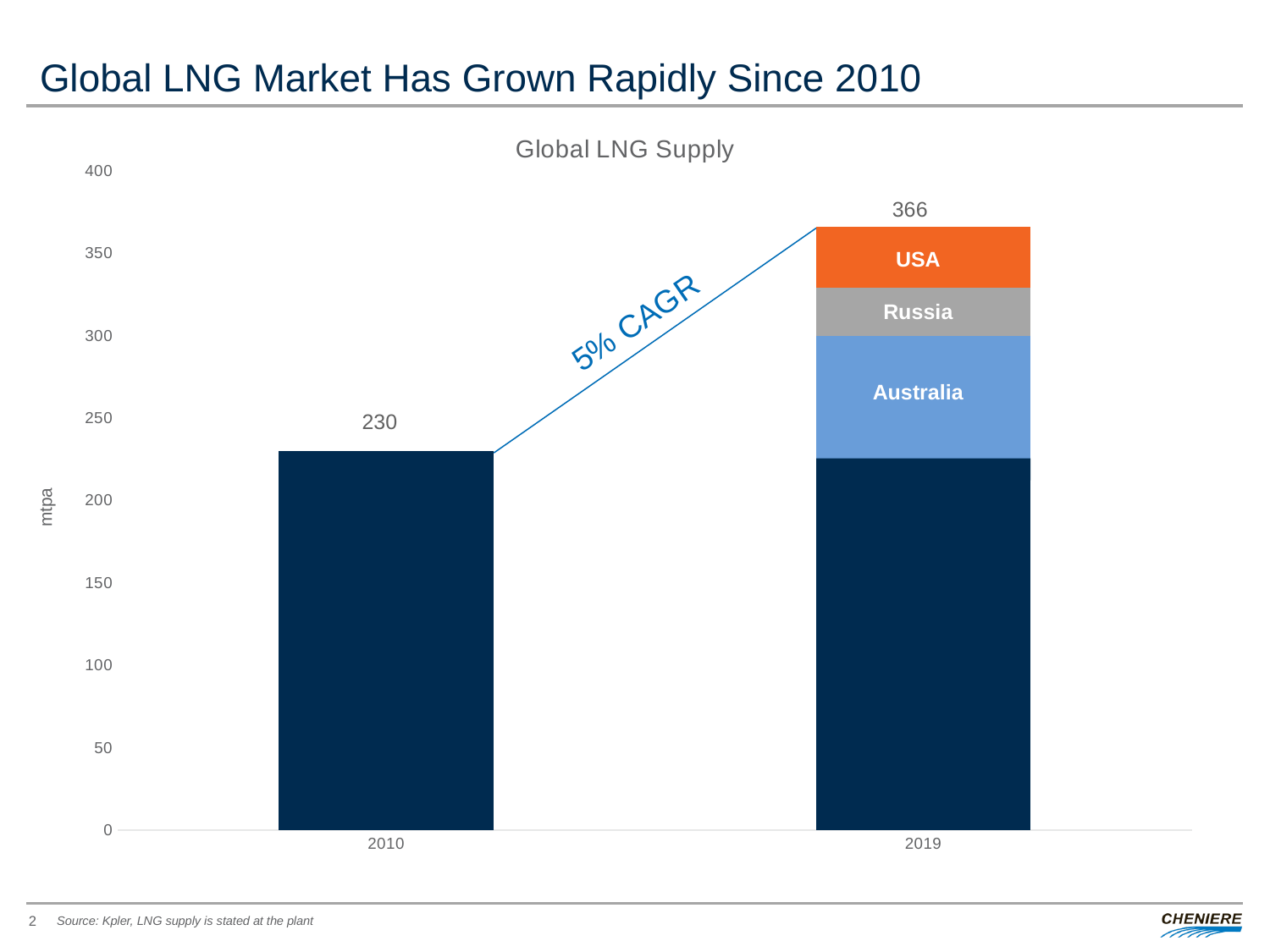
What kind of chart is this? Bar chart What is the difference between the 2019 total and the 2010 value? 136 What is the total value of the 2019 bar? 366 Which year has the larger value, 2010 or 2019? 2019 How many years are shown on the x axis? 2 Which year has the highest value? 2019 What is the value of the 2010 bar? 230 What is the title of the chart? Global LNG Supply Is the value for 2010 greater or less than 200? greater Which year has the lowest value? 2010 Do the values rise or fall from 2010 to 2019? Rise Which country is labelled on the top segment of the 2019 bar? USA